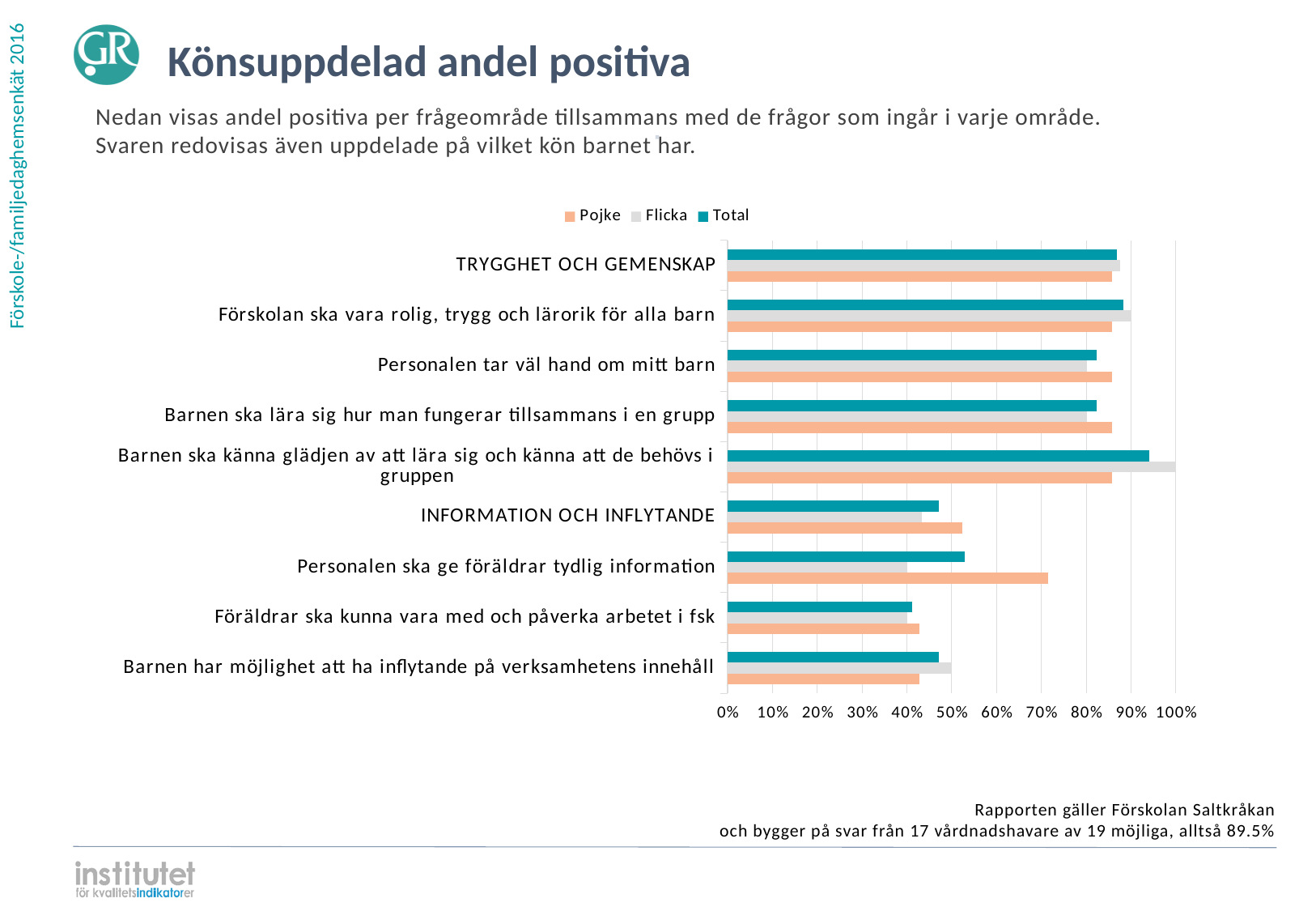
Which category has the lowest Total value? Föräldrar ska kunna vara med och påverka arbetet i fsk Is the Flicka value for 'Barnen ska känna glädjen av att lära sig och känna att de behövs i gruppen' greater or less than 90%? greater Is the Pojke value for 'Personalen ska ge föräldrar tydlig information' greater or less than 60%? greater What colour are the bars for the Total series? Teal How many series does the chart's legend list? 3 Is the Pojke value for 'TRYGGHET OCH GEMENSKAP' greater or less than 80%? greater For 'Personalen ska ge föräldrar tydlig information', which is larger: the Pojke value or the Flicka value? Pojke How many categories are plotted on the chart? 9 What kind of chart is shown on the slide? Bar chart Which series are listed in the chart's legend? Pojke, Flicka, Total Which category has the highest Flicka value? Barnen ska känna glädjen av att lära sig och känna att de behövs i gruppen